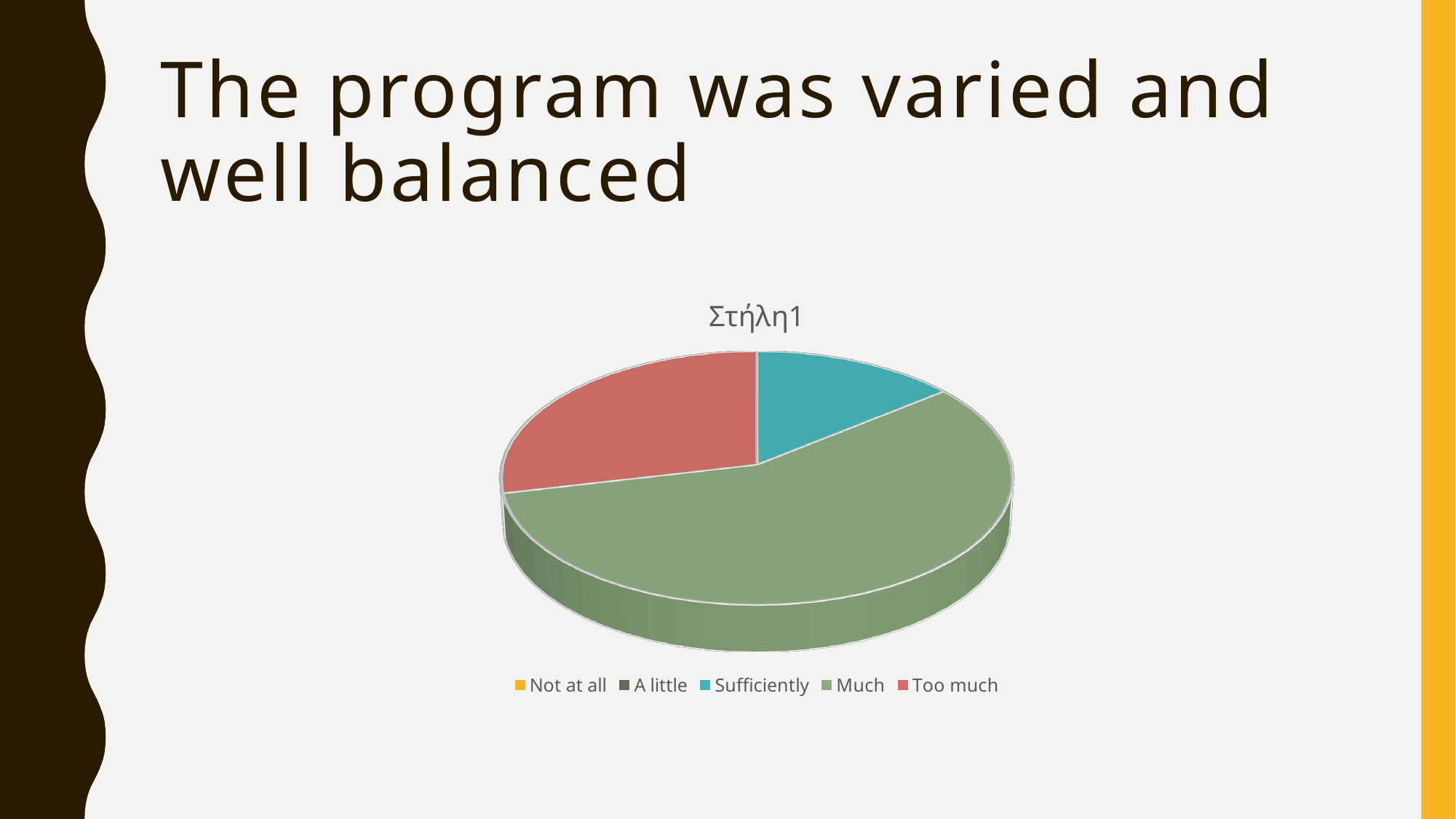
Which slice is larger, Sufficiently or Much? Much Which slice is larger, Too much or Sufficiently? Too much Which category has the largest slice of the pie? Much How many categories does the legend list? 5 Does the Much slice take up more or less than half of the pie? more What is the title shown above the pie chart? Στήλη1 What kind of chart is shown on the slide? pie chart What colour is the Too much slice? red How many slices are visible in the pie? 3 Of the slices visible in the pie, which is the smallest? Sufficiently